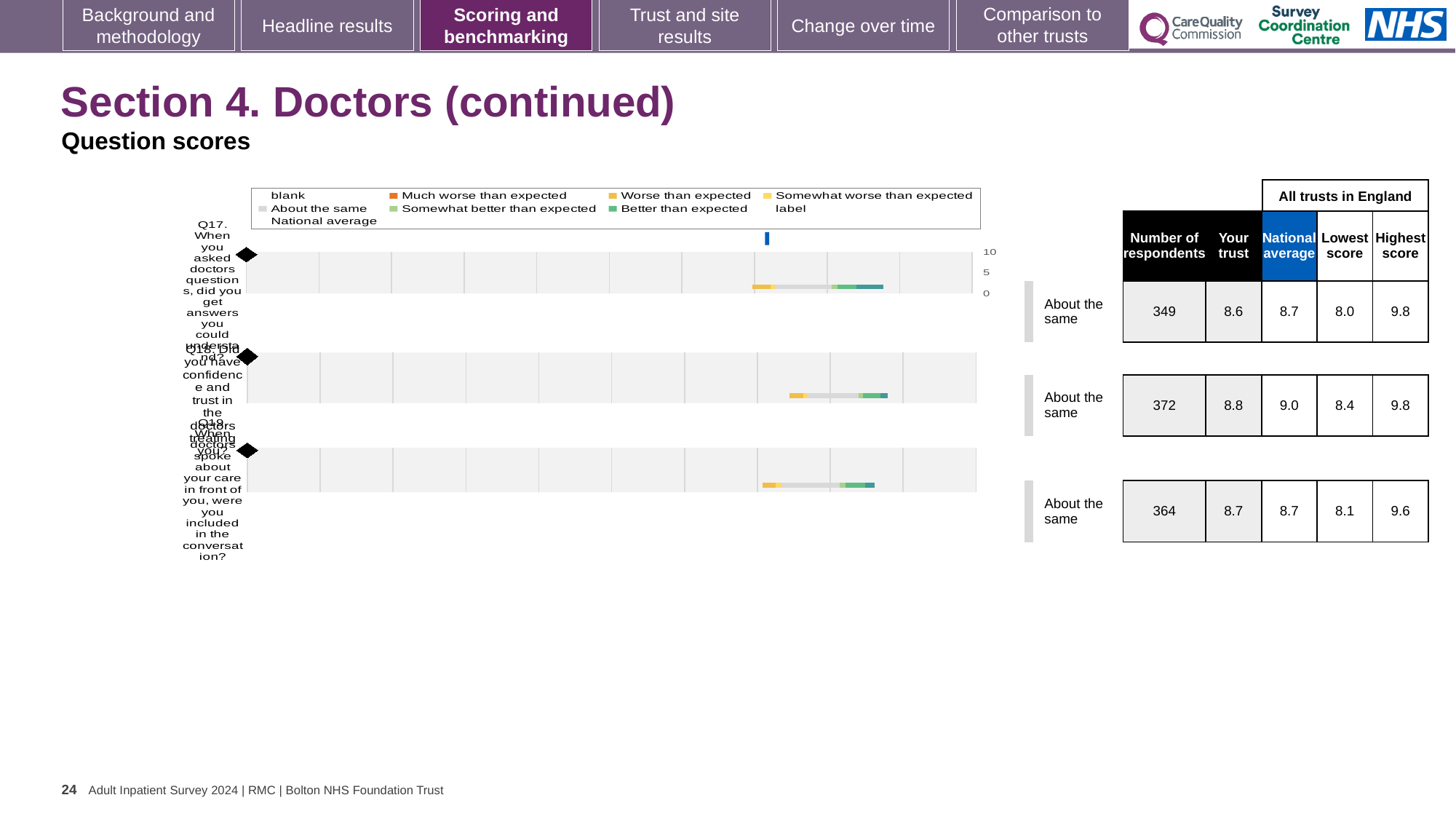
What kind of chart is used to show the question scores for Q17, Q18 and Q19? bar chart How many questions (bars) are plotted in the chart? 3 In the table beside the chart, what is the 'Your trust' score for Q18? 8.8 For Q18, which is larger: the 'Your trust' score or the national average? National average Which colour does the legend use for 'Much worse than expected'? orange For Q18, what is the difference between the highest score and the lowest score across all trusts in England? 1.4 Which question has the highest 'Your trust' score in the table? Q18 How many of the three questions are rated 'About the same'? 3 In the table beside the chart, what is the highest score for Q19? 9.6 In the table beside the chart, what is the number of respondents for Q17? 349 What benchmark category is shown next to the bar for Q17? About the same In the table beside the chart, what is the national average for Q18? 9.0